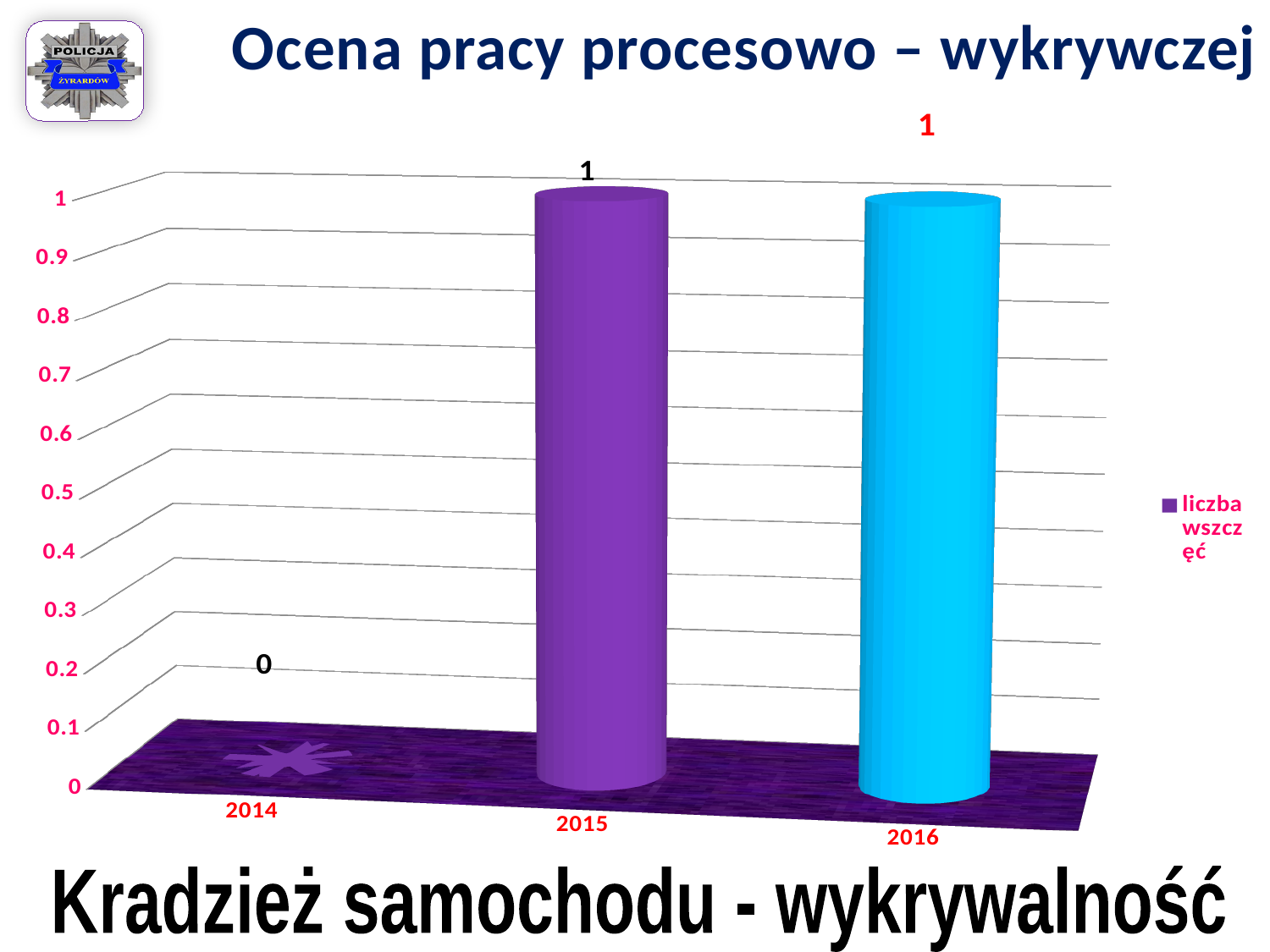
What is the difference between the values for 2015 and 2014? 1 How many series does the legend list? 1 Which year has the lowest value? 2014 Which is larger, the value for 2014 or the value for 2016? 2016 What is the title printed below the chart? Kradzież samochodu - wykrywalność Do the values rise or fall from 2014 to 2015? rise What is the value for 2015? 1 What is the value for 2016? 1 What kind of chart is shown on the slide? bar chart What is the value for 2014? 0 What is the legend entry for the series? liczba wszczęć How many years are shown on the x axis? 3